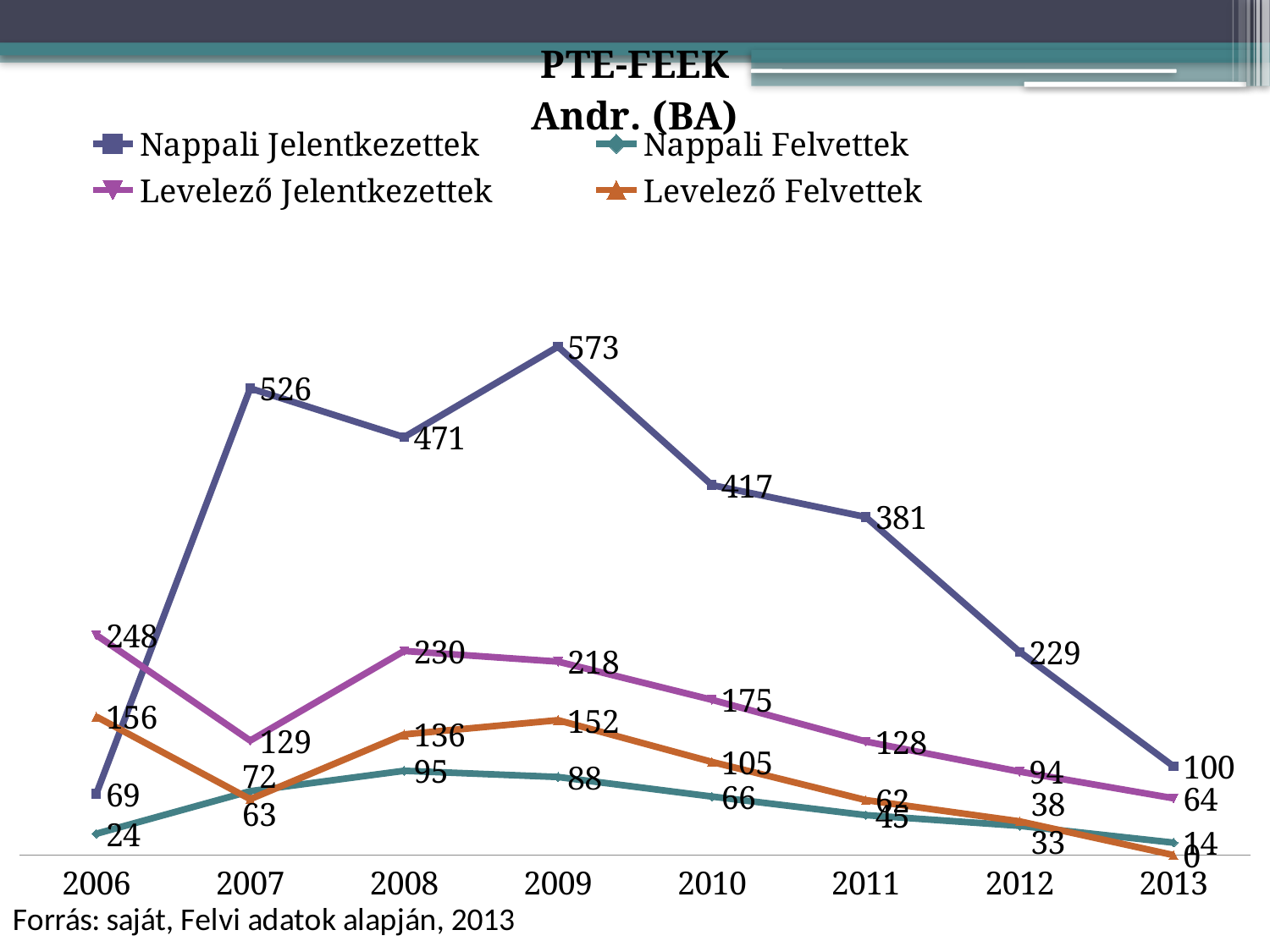
In which year is Nappali Jelentkezettek lowest? 2006 What is the value for Nappali Felvettek in 2008? 95 How many years are shown on the x axis? 8 Does Nappali Jelentkezettek rise or fall from 2009 to 2013? fall How many series does the legend list? 4 In which year is Nappali Jelentkezettek highest? 2009 What is the value for Nappali Jelentkezettek in 2009? 573 Which is larger in 2006: Nappali Jelentkezettek or Levelező Jelentkezettek? Levelező Jelentkezettek What is the difference between Nappali Jelentkezettek in 2007 and in 2008? 55 What is the value for Levelező Felvettek in 2010? 105 What is the value for Levelező Jelentkezettek in 2006? 248 What type of chart is shown on the slide? line chart